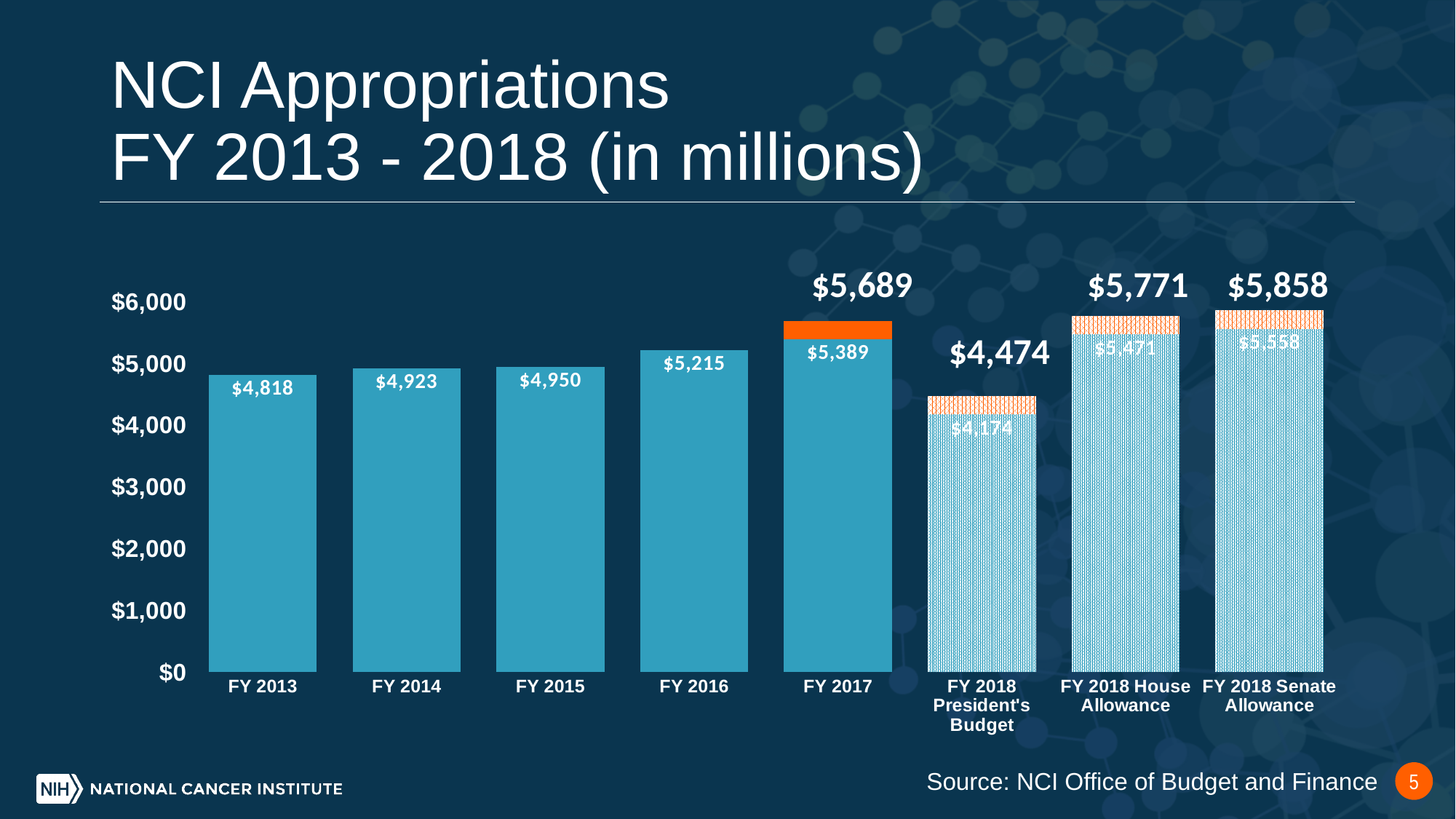
Which is larger, the FY 2018 House Allowance total or the FY 2018 Senate Allowance total? FY 2018 Senate Allowance What total is shown above the FY 2018 President's Budget bar? $4,474 What kind of chart is shown on the slide? Bar chart What is the value of the blue base segment of the FY 2017 bar? $5,389 What is the value labeled on the FY 2013 bar? $4,818 Which category has the highest total value? FY 2018 Senate Allowance How many bars are shown in the chart? 8 What total is shown above the FY 2018 Senate Allowance bar? $5,858 What total is shown above the FY 2017 bar? $5,689 What is the difference between the FY 2014 and FY 2013 values? $105 Which category has the lowest total value? FY 2018 President's Budget What is the value labeled on the FY 2016 bar? $5,215